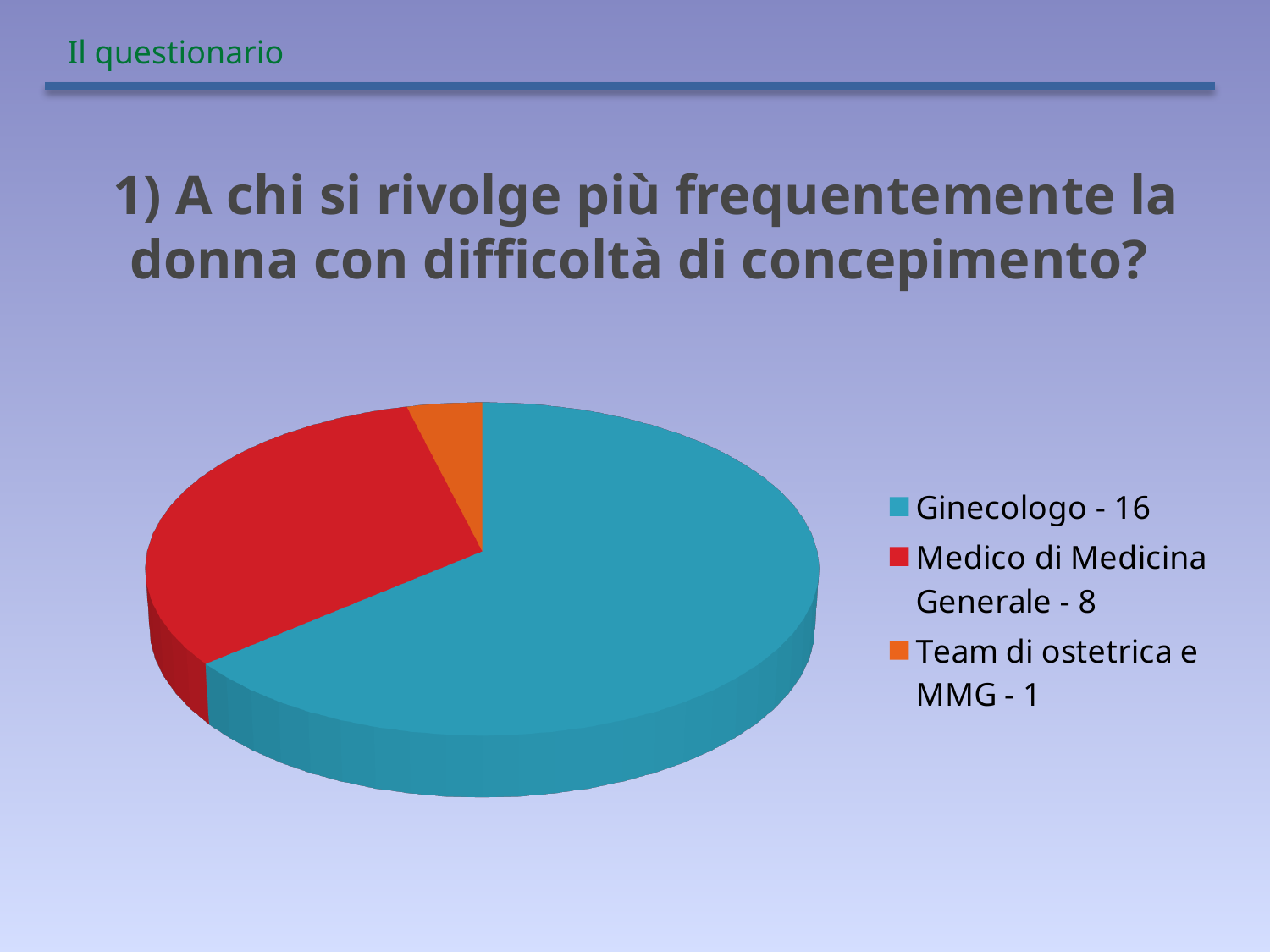
What value is given for Medico di Medicina Generale in the legend? 8 What is the total of all the values shown in the legend? 25 What value is given for Ginecologo in the legend? 16 What is the difference between the values for Ginecologo and Medico di Medicina Generale? 8 Which is larger, the value for Medico di Medicina Generale or the value for Team di ostetrica e MMG? Medico di Medicina Generale What share of the pie does the Ginecologo slice represent? 64% How many slices does the pie chart have? 3 What colour is the slice for Medico di Medicina Generale? red Which category has the largest slice of the pie? Ginecologo What kind of chart is shown on the slide? pie chart What value is given for Team di ostetrica e MMG in the legend? 1 Which category has the smallest slice of the pie? Team di ostetrica e MMG